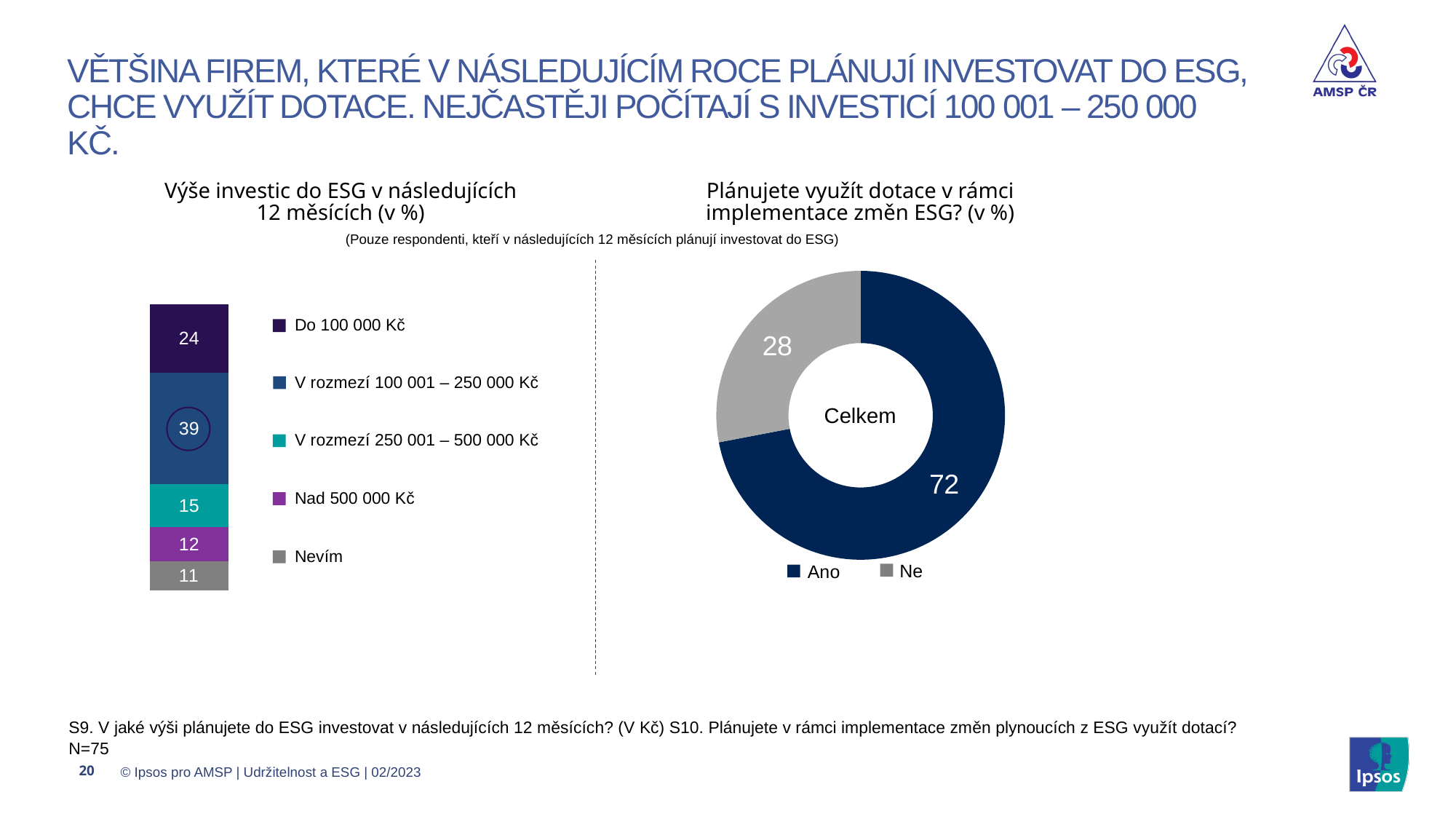
In the right chart 'Plánujete využít dotace v rámci implementace změn ESG? (v %)', what is the value for 'Ano'? 72 What type of chart is the right chart 'Plánujete využít dotace v rámci implementace změn ESG? (v %)'? Donut (pie) chart In the left chart 'Výše investic do ESG v následujících 12 měsících (v %)', which is larger: 'V rozmezí 250 001 – 500 000 Kč' or 'Nad 500 000 Kč'? V rozmezí 250 001 – 500 000 Kč In the right chart 'Plánujete využít dotace v rámci implementace změn ESG? (v %)', what is the value for 'Ne'? 28 In the left chart 'Výše investic do ESG v následujících 12 měsících (v %)', which category has the lowest value? Nevím In the left chart 'Výše investic do ESG v následujících 12 měsících (v %)', which category has the highest value? V rozmezí 100 001 – 250 000 Kč In the left chart 'Výše investic do ESG v následujících 12 měsících (v %)', what is the value for 'Do 100 000 Kč'? 24 In the left chart 'Výše investic do ESG v následujících 12 měsících (v %)', what is the value for 'Nevím'? 11 How many categories does the legend of the left chart 'Výše investic do ESG v následujících 12 měsících (v %)' list? 5 In the left chart 'Výše investic do ESG v následujících 12 měsících (v %)', what is the value for 'V rozmezí 100 001 – 250 000 Kč'? 39 In the right chart 'Plánujete využít dotace v rámci implementace změn ESG? (v %)', what is the difference between 'Ano' and 'Ne'? 44 In the left chart 'Výše investic do ESG v následujících 12 měsících (v %)', what is the difference between 'V rozmezí 100 001 – 250 000 Kč' and 'Do 100 000 Kč'? 15